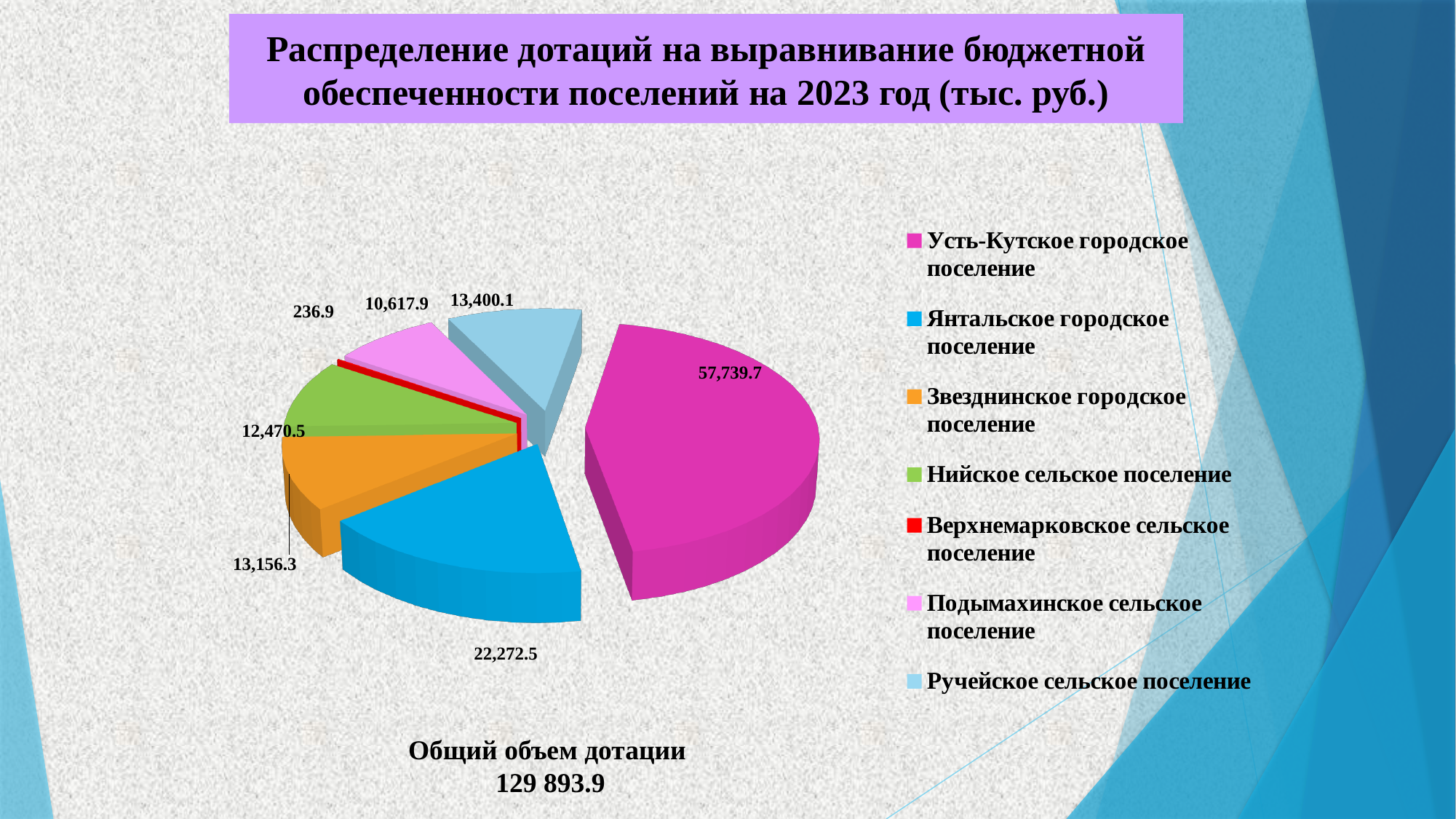
What is the total volume of the subsidy stated on the slide? 129 893.9 How many settlements (slices) does the pie chart show? 7 What colour is the slice for Звезднинское городское поселение? Orange What is the difference between the values for Усть-Кутское городское поселение and Янтальское городское поселение? 35,467.2 Which settlement receives the smallest share of the subsidy? Верхнемарковское сельское поселение Which is larger: the value for Нийское сельское поселение or Подымахинское сельское поселение? Нийское сельское поселение What is the value for Подымахинское сельское поселение? 10,617.9 What type of chart is shown on the slide? Pie chart What is the value for Верхнемарковское сельское поселение? 236.9 What is the value for Усть-Кутское городское поселение? 57,739.7 What is the value for Янтальское городское поселение? 22,272.5 Which settlement receives the largest share of the subsidy? Усть-Кутское городское поселение